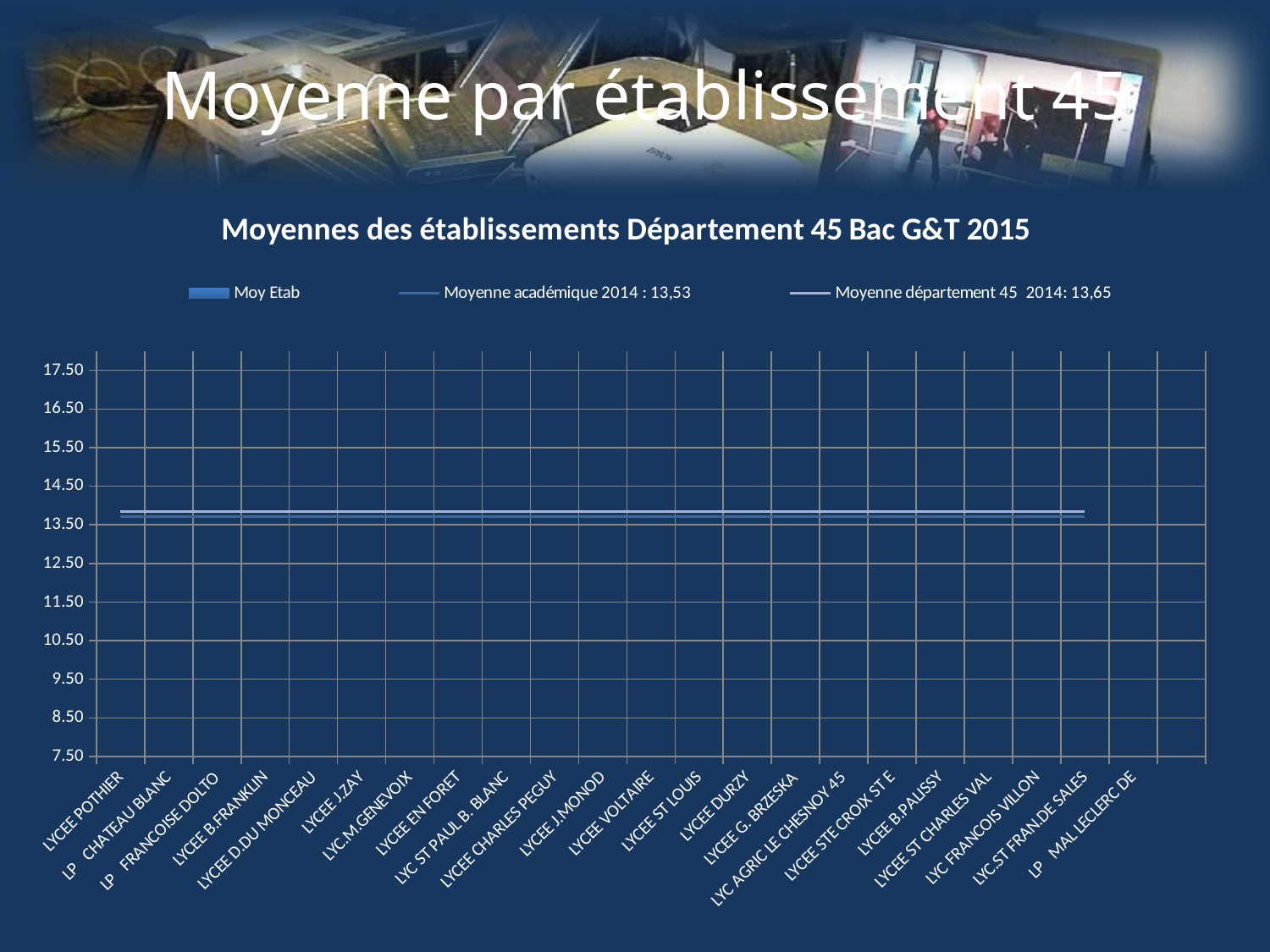
Which is higher, the Moyenne académique 2014 or the Moyenne département 45 2014? Moyenne département 45 2014 What value does the legend give for 'Moyenne département 45 2014'? 13,65 How many establishments (categories) are listed along the x axis? 22 What is the difference between the Moyenne département 45 2014 (13,65) and the Moyenne académique 2014 (13,53)? 0,12 What is the title of the chart? Moyennes des établissements Département 45 Bac G&T 2015 Is the Moyenne académique 2014 line greater or less than 12.50 on the y axis? greater What is the lowest value shown on the y axis? 7.50 What is the highest value shown on the y axis? 17.50 What value does the legend give for 'Moyenne académique 2014'? 13,53 How many series does the chart legend list? 3 Is the Moyenne département 45 2014 line greater or less than 14.50 on the y axis? less What is the first establishment listed on the x axis? LYCEE POTHIER